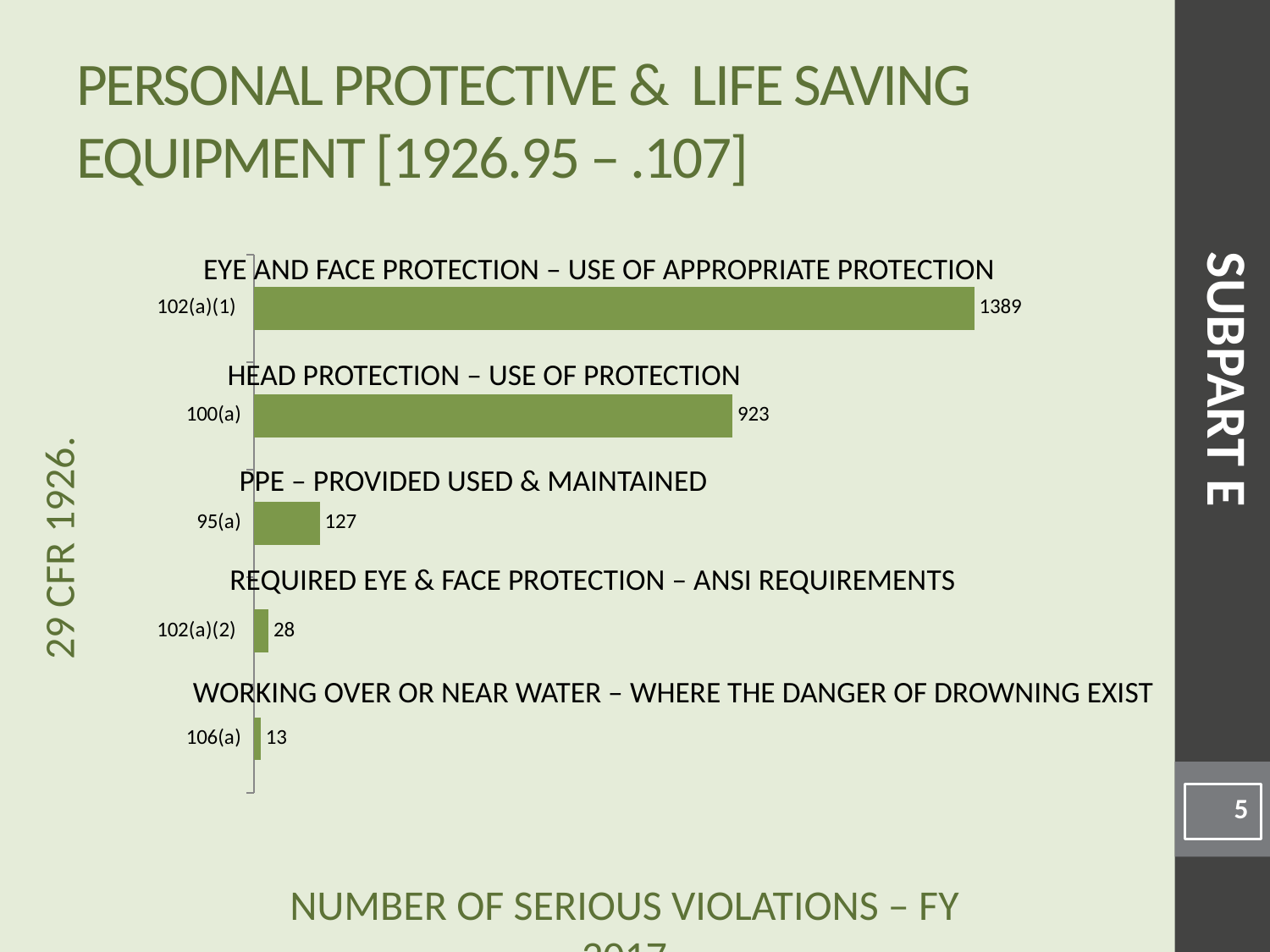
What is the number of serious violations for 102(a)(1)? 1389 What is the number of serious violations for 95(a)? 127 How many categories are shown in the chart? 5 Which category has the highest number of serious violations? 102(a)(1) What is the difference between the values for 95(a) and 102(a)(2)? 99 What kind of chart is shown on the slide? bar chart What is the number of serious violations for 100(a)? 923 What is the difference between the values for 102(a)(1) and 100(a)? 466 What is the number of serious violations for 106(a)? 13 Which category has the lowest number of serious violations? 106(a) Which is larger, the value for 100(a) or the value for 95(a)? 100(a)